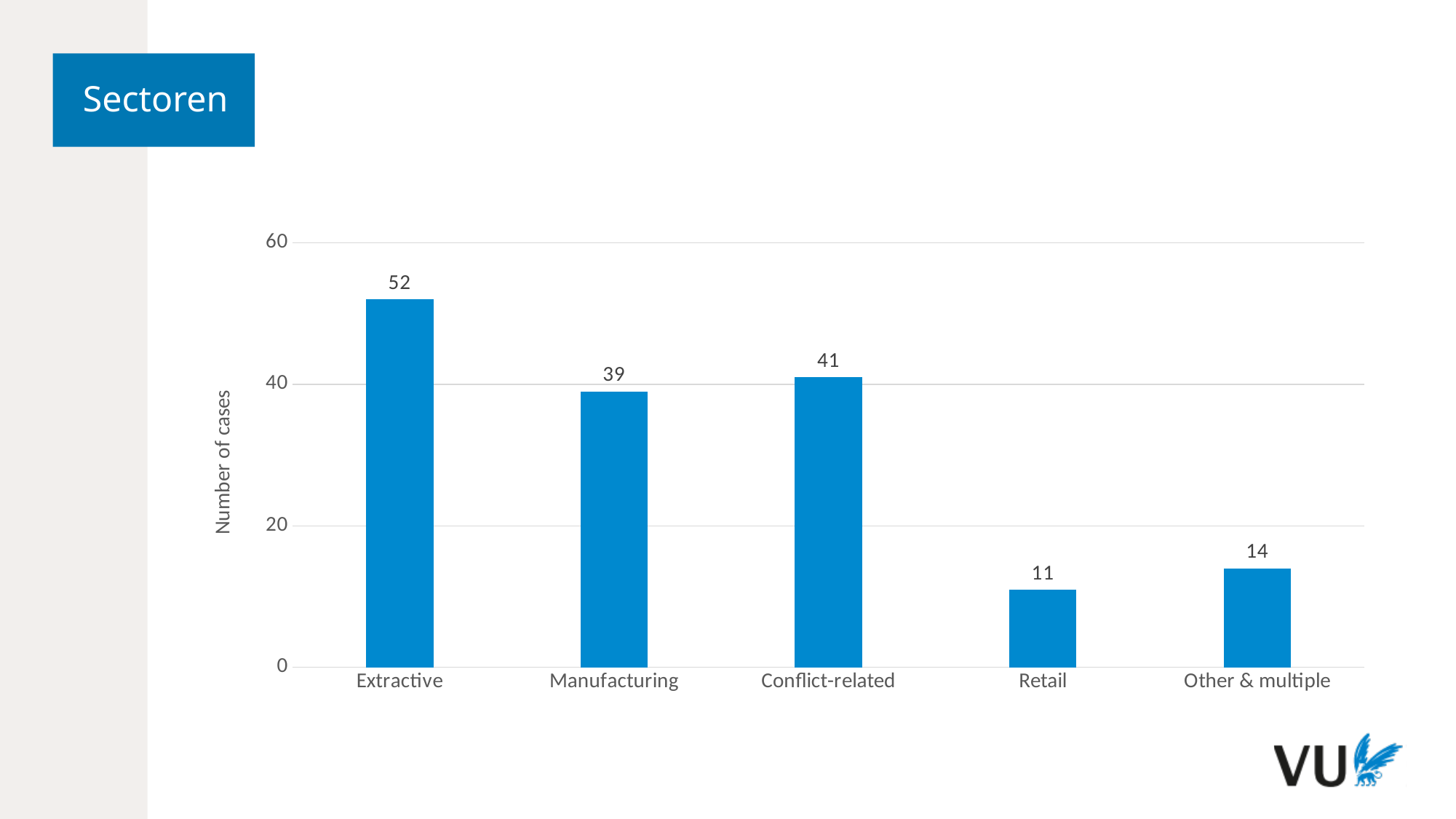
What is the difference in number of cases between Extractive and Manufacturing? 13 How many sectors are shown on the chart? 5 What is the number of cases for Other & multiple? 14 Is the value for Manufacturing greater or less than 40? less What is the number of cases for Retail? 11 What kind of chart is shown on the slide? bar chart What is the number of cases for Extractive? 52 Which sector has the lowest number of cases? Retail What is the difference in number of cases between Conflict-related and Retail? 30 Which sector has the highest number of cases? Extractive Which has more cases, Manufacturing or Conflict-related? Conflict-related What is the label of the vertical axis? Number of cases